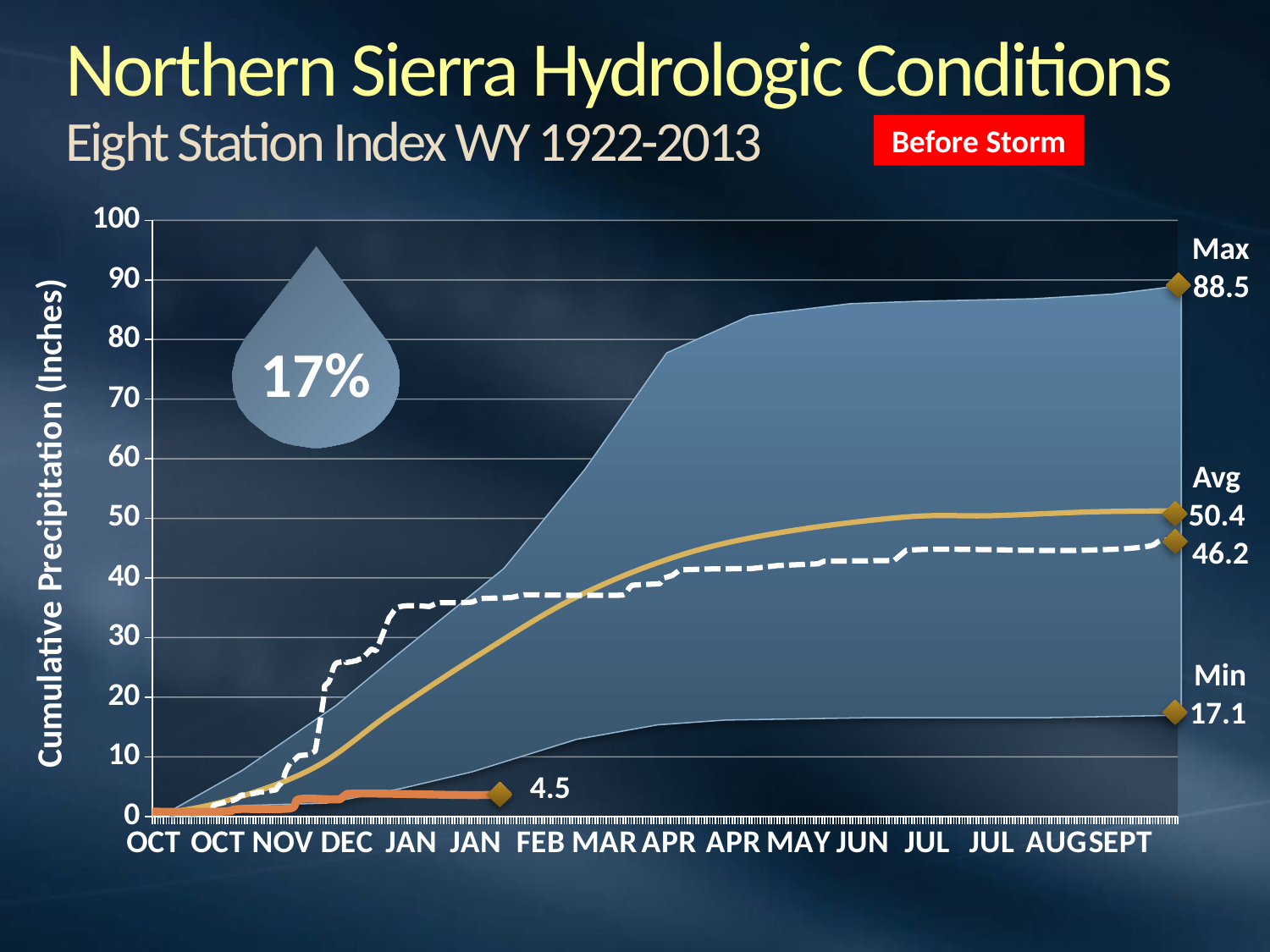
Does the Avg line rise or fall from OCT to SEPT? rise What is the Max value shown at the end of the chart? 88.5 Is the Max line's value at APR greater or less than 70? greater What value is labeled at the end of the orange line in January? 4.5 What is the Avg value shown at the end of the chart? 50.4 What is the label of the y axis? Cumulative Precipitation (Inches) What is the Min value shown at the end of the chart? 17.1 What is the difference between the Max value (88.5) and the Min value (17.1)? 71.4 Is the Min value at SEPT greater or less than 20? less What is the difference between the Avg value (50.4) and the Min value (17.1)? 33.3 Which is larger, the Avg value or the Min value? Avg What kind of chart is shown on the slide? line chart